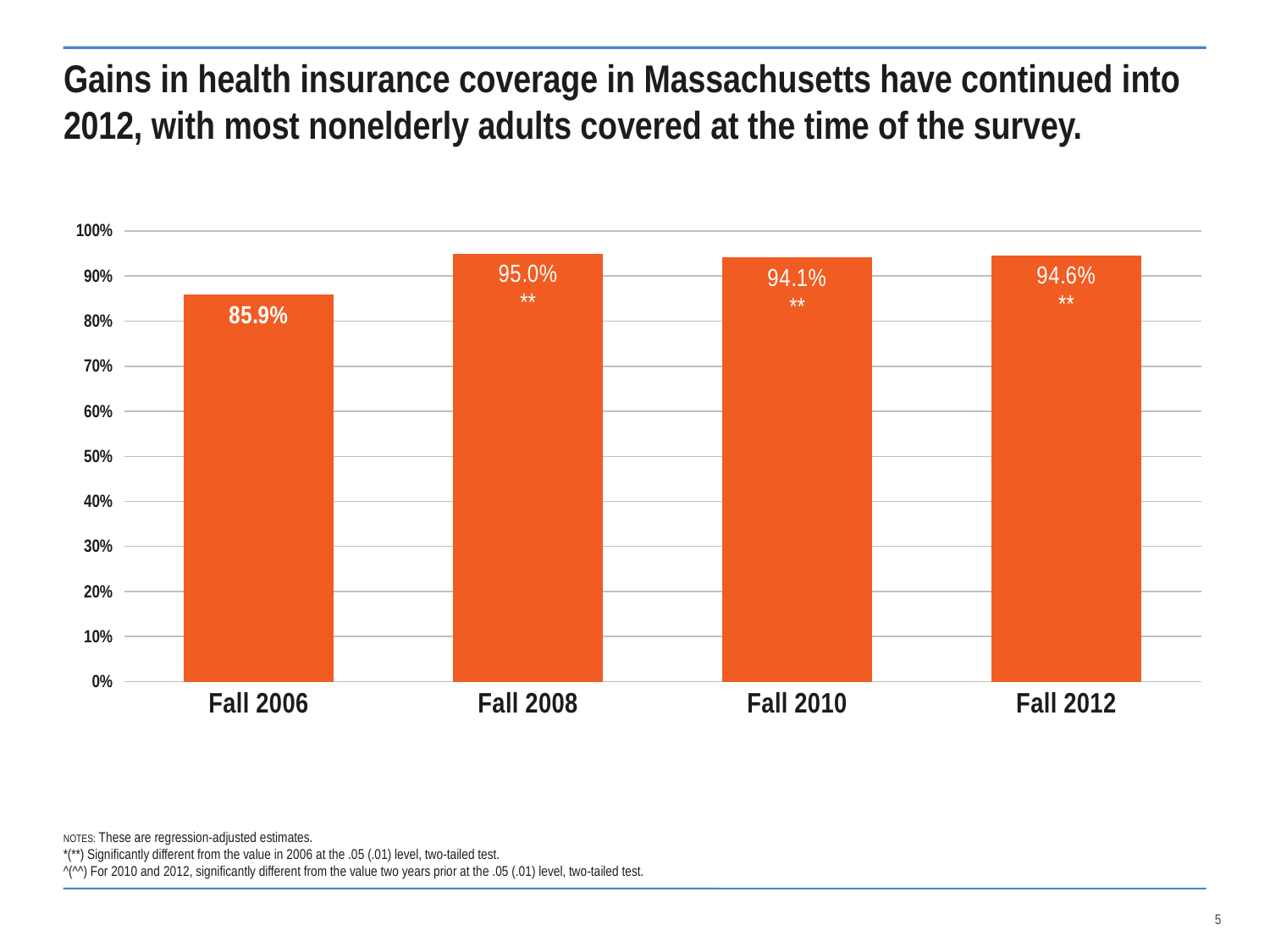
What is the difference between the values for Fall 2012 and Fall 2010? 0.5 percentage points Is the value for Fall 2006 greater or less than 90%? less Which category has the lowest value? Fall 2006 How many categories are shown on the x axis? 4 What is the value for Fall 2006? 85.9% What is the value for Fall 2008? 95.0% Which category has the highest value? Fall 2008 What is the value for Fall 2012? 94.6% What kind of chart is shown on the slide? Bar chart Which is larger, the value for Fall 2006 or the value for Fall 2010? Fall 2010 What is the difference between the values for Fall 2008 and Fall 2006? 9.1 percentage points What is the value for Fall 2010? 94.1%